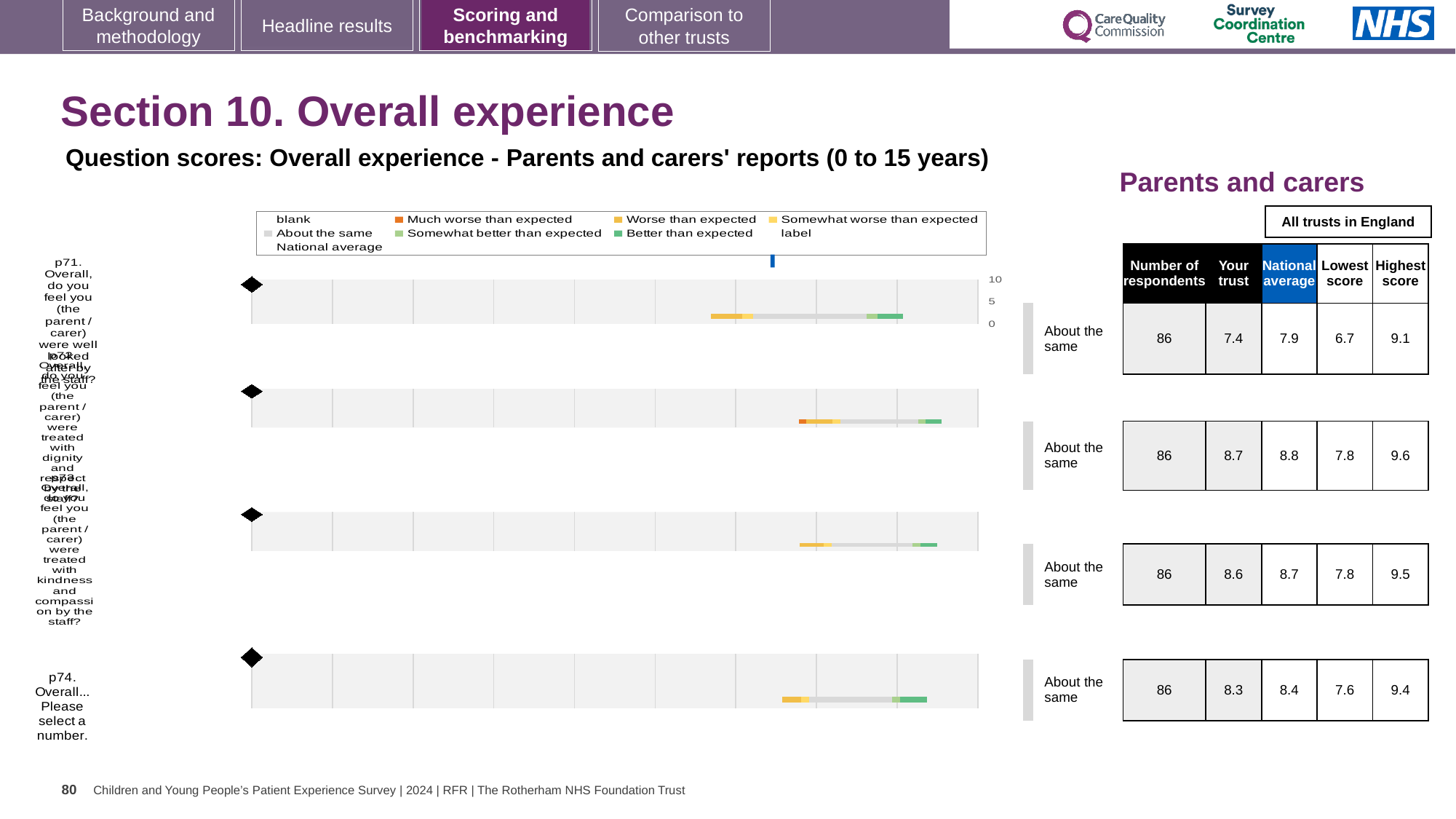
According to the table beside the chart, what is the trust's score for p71 (Overall, do you feel you were well looked after by the staff?)? 7.4 How many respondents are listed for each question in the table beside the chart? 86 What is the highest value shown on the chart's axis? 10 How many questions (bars) are plotted in the chart? 4 Which question has the highest 'Your trust' score in the table beside the chart? p72 How many entries does the chart legend list? 9 According to the table beside the chart, what is the national average for p74 (Overall... Please select a number)? 8.4 Which question has the lowest 'Your trust' score in the table beside the chart? p71 What kind of chart is shown on the slide? bar chart What is the title of the chart? Question scores: Overall experience - Parents and carers' reports (0 to 15 years) Is the trust score for p73 larger or smaller than the trust score for p74 in the table beside the chart? larger What is the difference between the national average and the trust score for p71 in the table beside the chart? 0.5